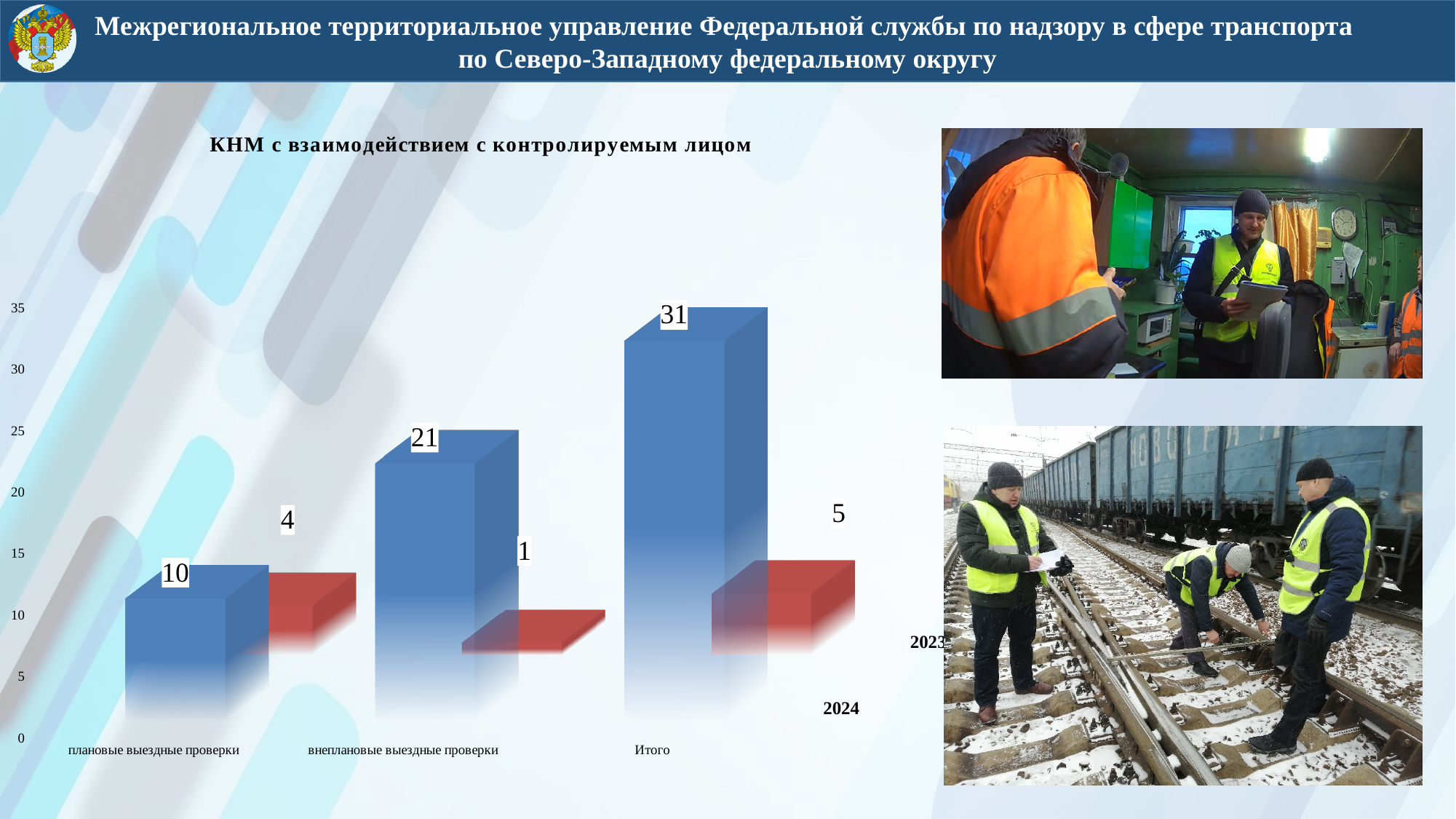
What is the value for Итого in 2023? 5 What is the title of the chart? КНМ с взаимодействием с контролируемым лицом Which category has the lowest value in 2023? внеплановые выездные проверки What is the value for внеплановые выездные проверки in 2024? 21 What is the value for Итого in 2024? 31 What is the difference between the 2024 and 2023 values for внеплановые выездные проверки? 20 Which is larger: the 2024 value for плановые выездные проверки or the 2024 value for внеплановые выездные проверки? внеплановые выездные проверки What is the value for внеплановые выездные проверки in 2023? 1 What type of chart is shown on the slide? bar chart What is the value for плановые выездные проверки in 2024? 10 What is the value for плановые выездные проверки in 2023? 4 How many categories are shown on the x axis of the chart? 3